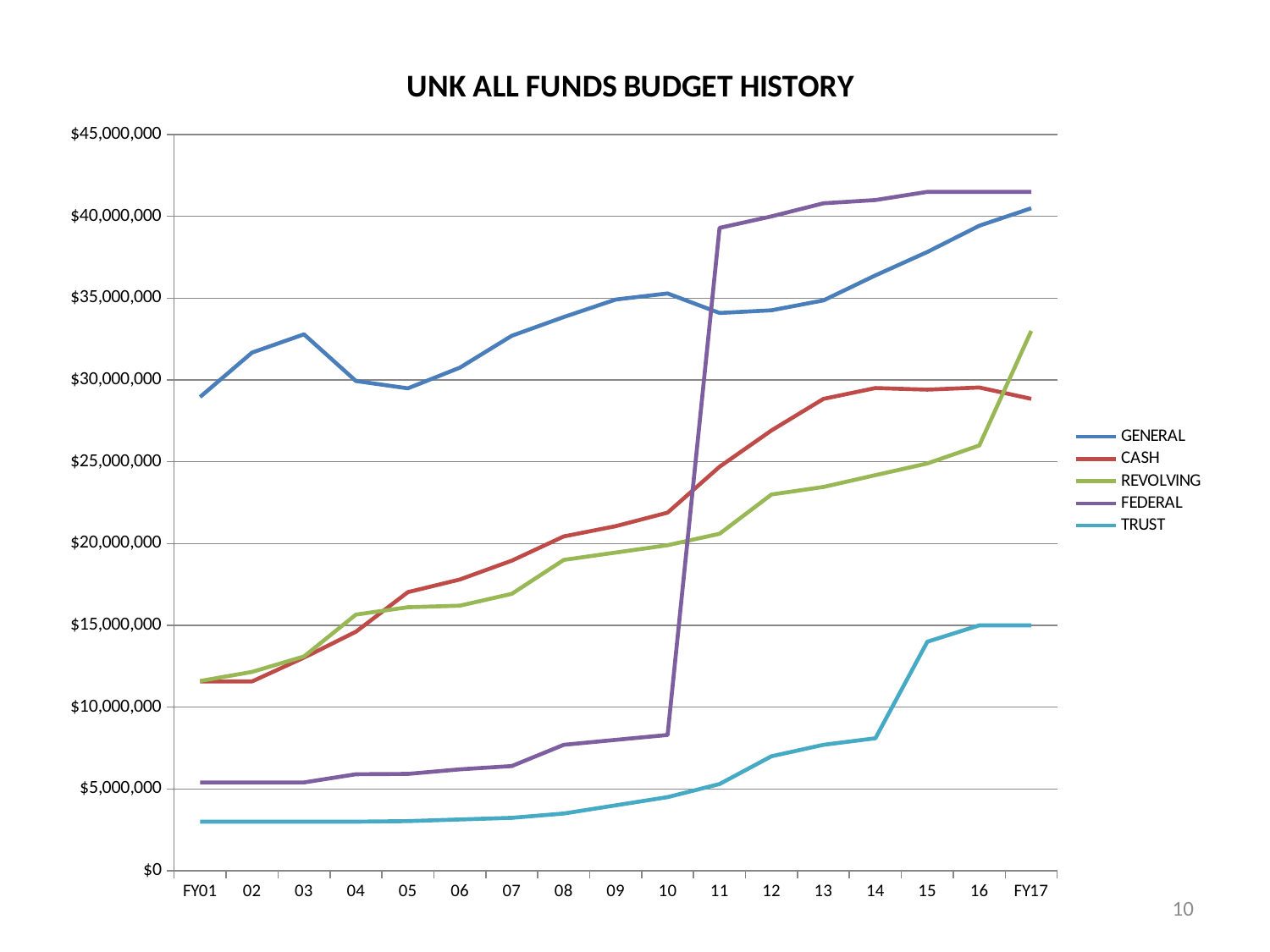
Which series has the lowest value in FY01? TRUST Is the value for FEDERAL in FY10 greater or less than $10,000,000? less Is the value for REVOLVING in FY17 greater or less than $30,000,000? greater What is the title of the chart? UNK ALL FUNDS BUDGET HISTORY What kind of chart is shown on the slide? line chart In FY17, which is larger, CASH or REVOLVING? REVOLVING How many fiscal years are plotted along the x axis? 17 In FY01, which is larger, GENERAL or FEDERAL? GENERAL Is the value for GENERAL in FY01 greater or less than $25,000,000? greater How many series does the legend list? 5 Does the TRUST series generally rise or fall from FY01 to FY17? rise